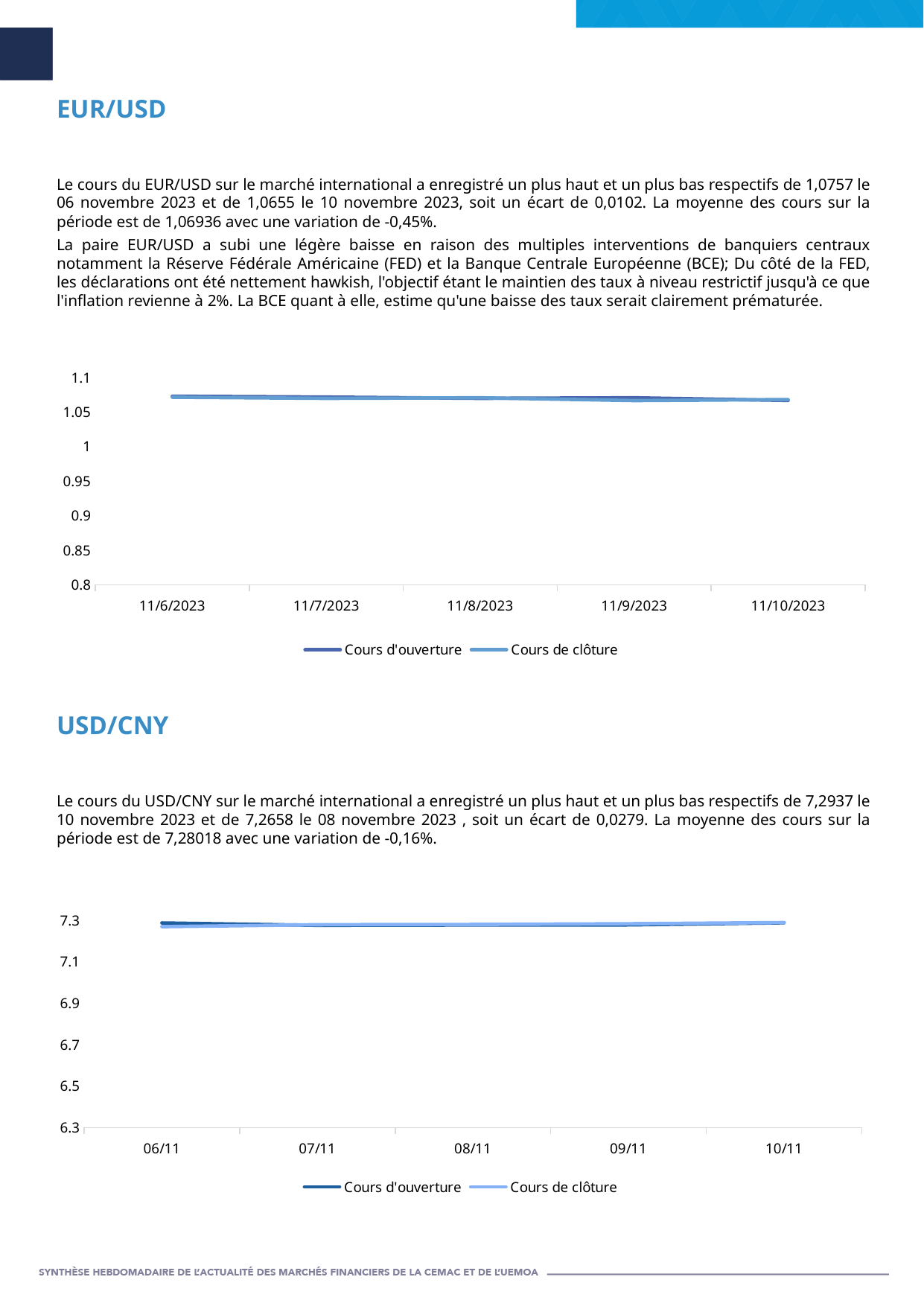
How many dates are shown on the x axis of the USD/CNY chart? 5 In the USD/CNY chart, is the value of Cours d'ouverture on 06/11 greater or less than 7.1? greater How many dates are shown on the x axis of the EUR/USD chart? 5 In the EUR/USD chart, is the value of Cours d'ouverture on 11/6/2023 greater or less than 1? greater In the USD/CNY chart, is the value of Cours de clôture on 10/11 greater or less than 6.9? greater In the EUR/USD chart, do the values of Cours d'ouverture rise or fall from 11/6/2023 to 11/10/2023? fall How many series does the legend of the EUR/USD chart list? 2 What kind of chart is the EUR/USD chart? line chart What are the two legend entries of the USD/CNY chart? Cours d'ouverture and Cours de clôture How many series does the legend of the USD/CNY chart list? 2 What kind of chart is the USD/CNY chart? line chart